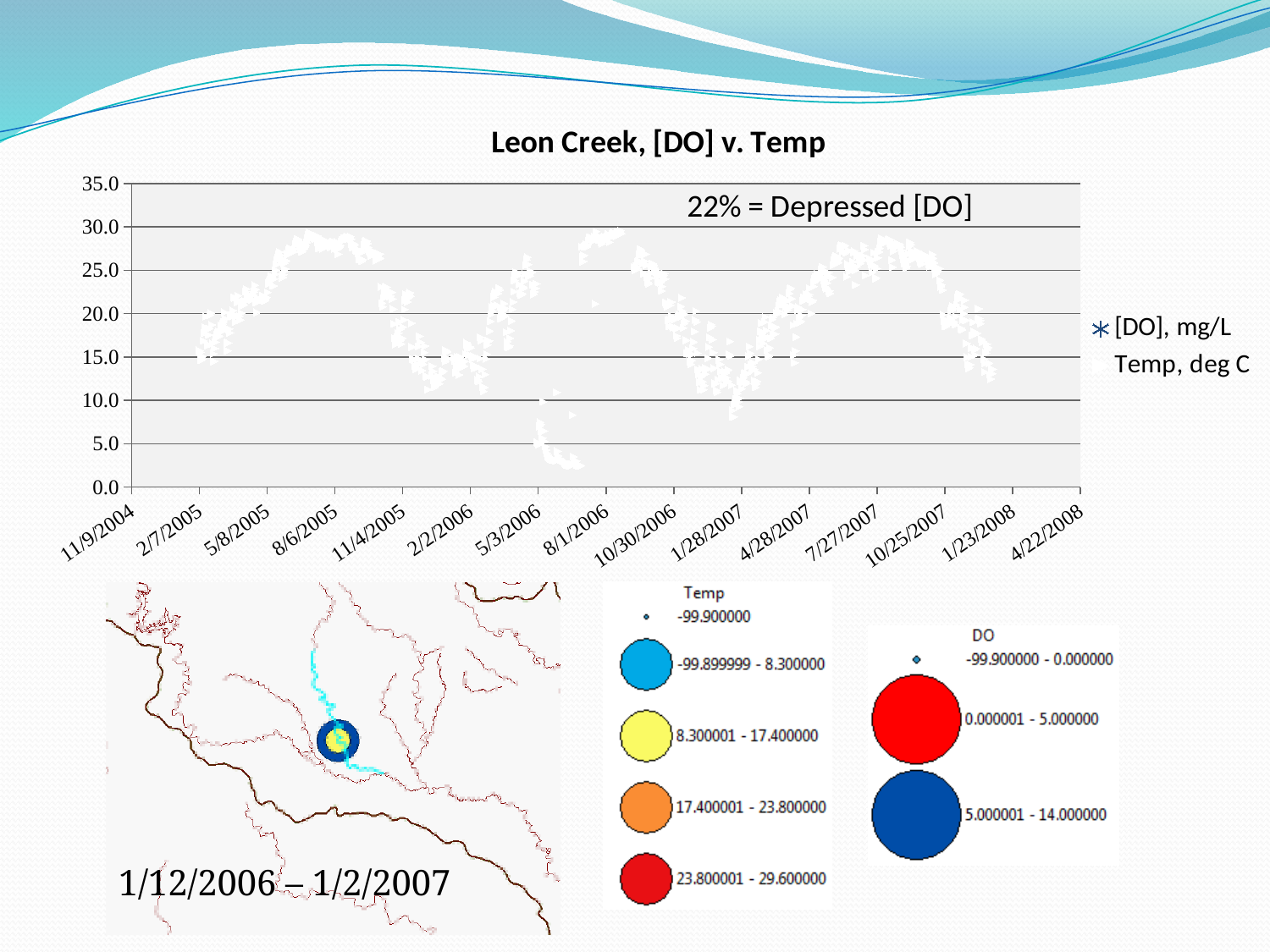
What percentage is given in the annotation on the Leon Creek chart for Depressed [DO]? 22% What are the two series named in the legend of the Leon Creek chart? [DO], mg/L and Temp, deg C How many date labels are shown on the x axis of the Leon Creek chart? 15 How many series does the legend of the Leon Creek chart list? 2 What is the first date label on the x axis of the Leon Creek chart? 11/9/2004 What is the interval between consecutive y-axis tick labels on the Leon Creek chart? 5.0 What kind of chart is the Leon Creek, [DO] v. Temp chart? scatter chart What is the last date label on the x axis of the Leon Creek chart? 4/22/2008 What is the highest value shown on the y axis of the Leon Creek chart? 35.0 What is the title of the chart on the slide? Leon Creek, [DO] v. Temp